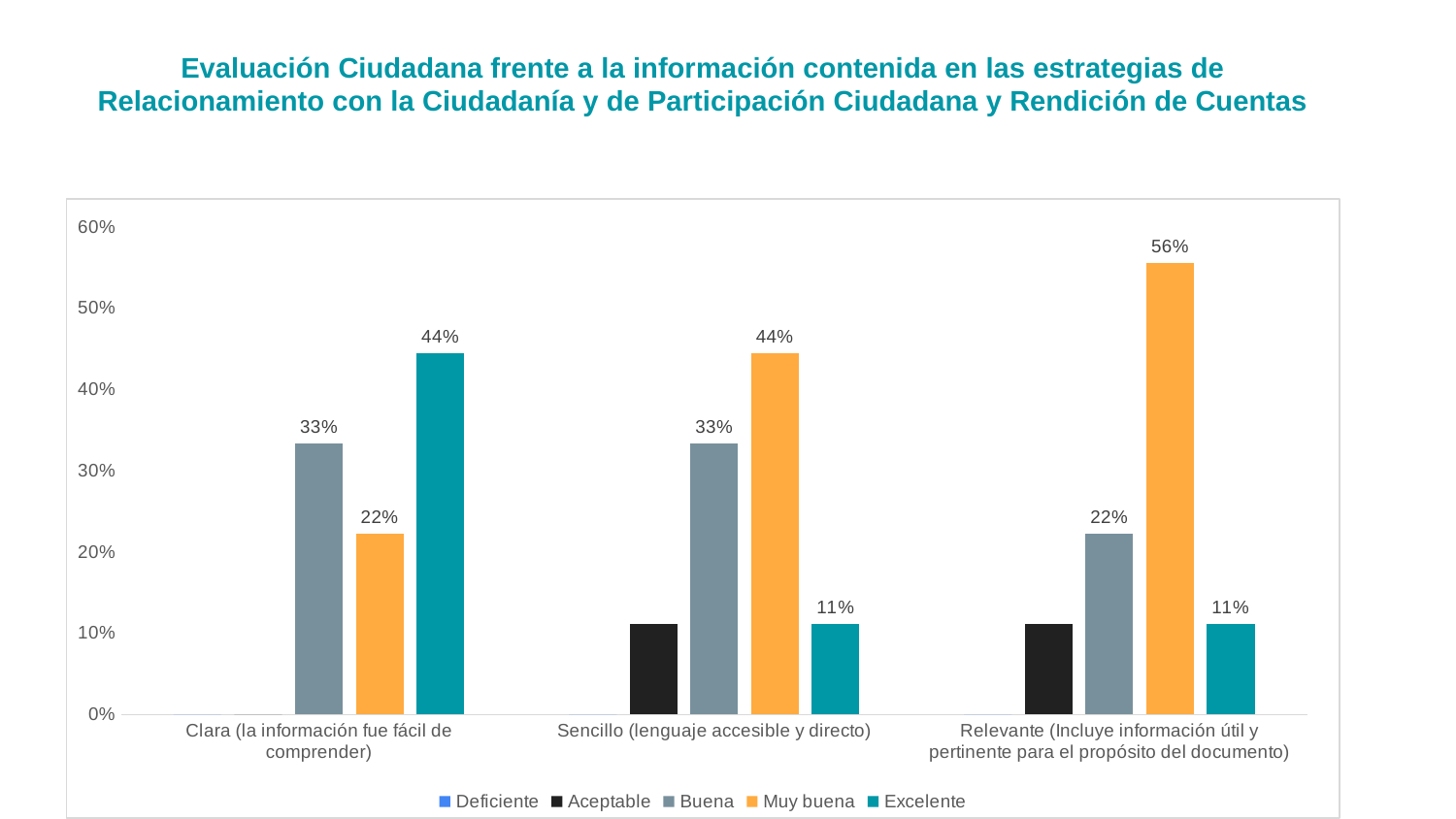
What is the difference between Muy buena and Excelente for Sencillo (lenguaje accesible y directo)? 33% Which is larger for Clara (la información fue fácil de comprender): Buena or Muy buena? Buena Which series has the highest value for Relevante (Incluye información útil y pertinente para el propósito del documento)? Muy buena What is the value of Buena for Sencillo (lenguaje accesible y directo)? 33% What kind of chart is shown on the slide? bar chart What is the value of Muy buena for Relevante (Incluye información útil y pertinente para el propósito del documento)? 56% Which series has the highest value for Clara (la información fue fácil de comprender)? Excelente Is the value of Aceptable for Sencillo (lenguaje accesible y directo) greater or less than 20%? less What is the value of Excelente for Clara (la información fue fácil de comprender)? 44% What is the value of Excelente for Sencillo (lenguaje accesible y directo)? 11% How many series does the legend list? 5 How many categories are shown on the x axis? 3